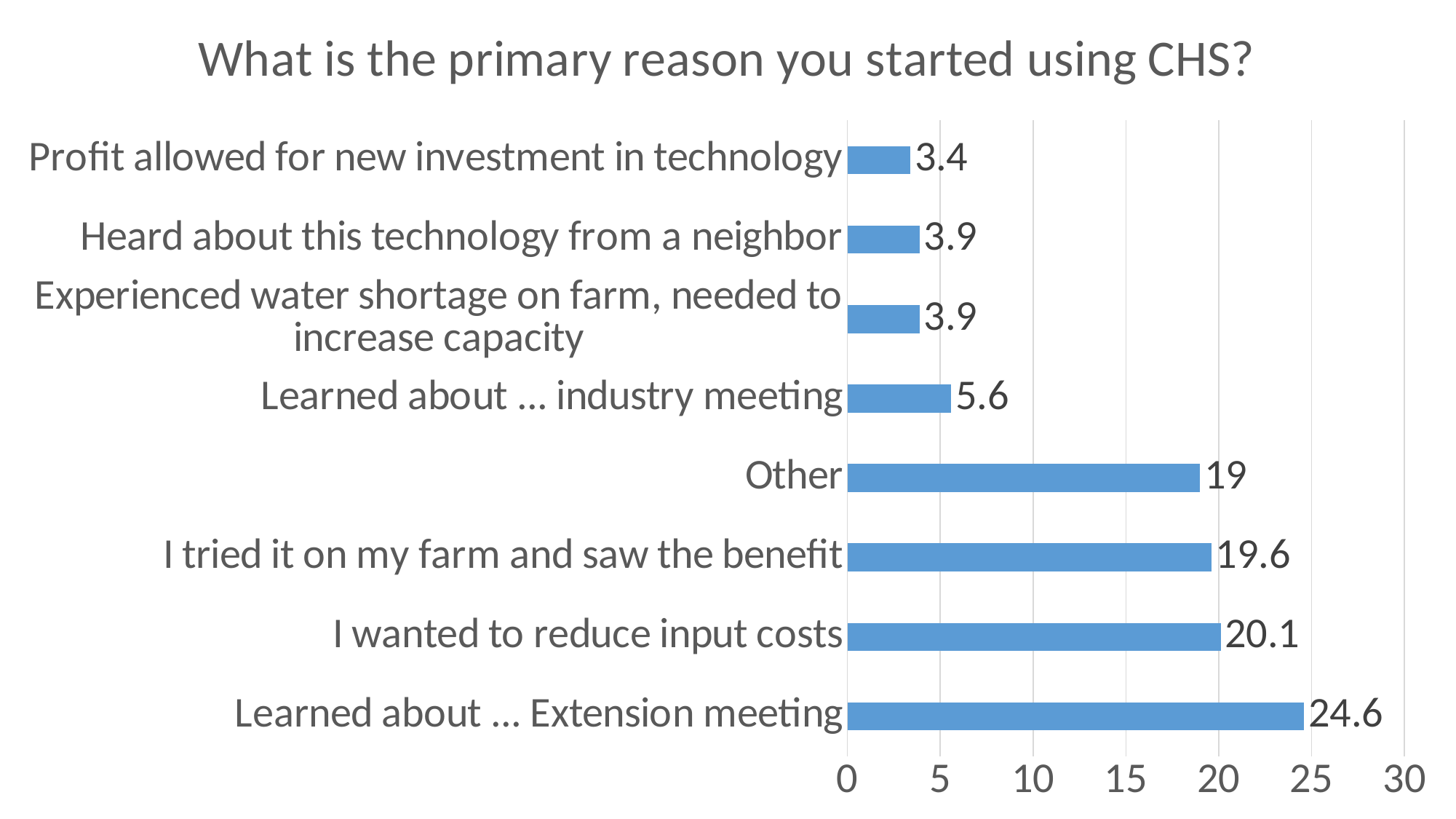
Which category has the lowest value? Profit allowed for new investment in technology What is the difference between the values for "Other" and "Learned about ... industry meeting"? 13.4 What is the value for "Other"? 19 What is the value for "I wanted to reduce input costs"? 20.1 What is the value for "Learned about ... industry meeting"? 5.6 What is the difference between the values for "Learned about ... Extension meeting" and "I wanted to reduce input costs"? 4.5 Which is larger, the value for "I tried it on my farm and saw the benefit" or the value for "Other"? I tried it on my farm and saw the benefit How many categories are shown in the chart? 8 Which category has the highest value? Learned about ... Extension meeting What is the title of the chart? What is the primary reason you started using CHS? What kind of chart is this? Bar chart What is the value for "Profit allowed for new investment in technology"? 3.4